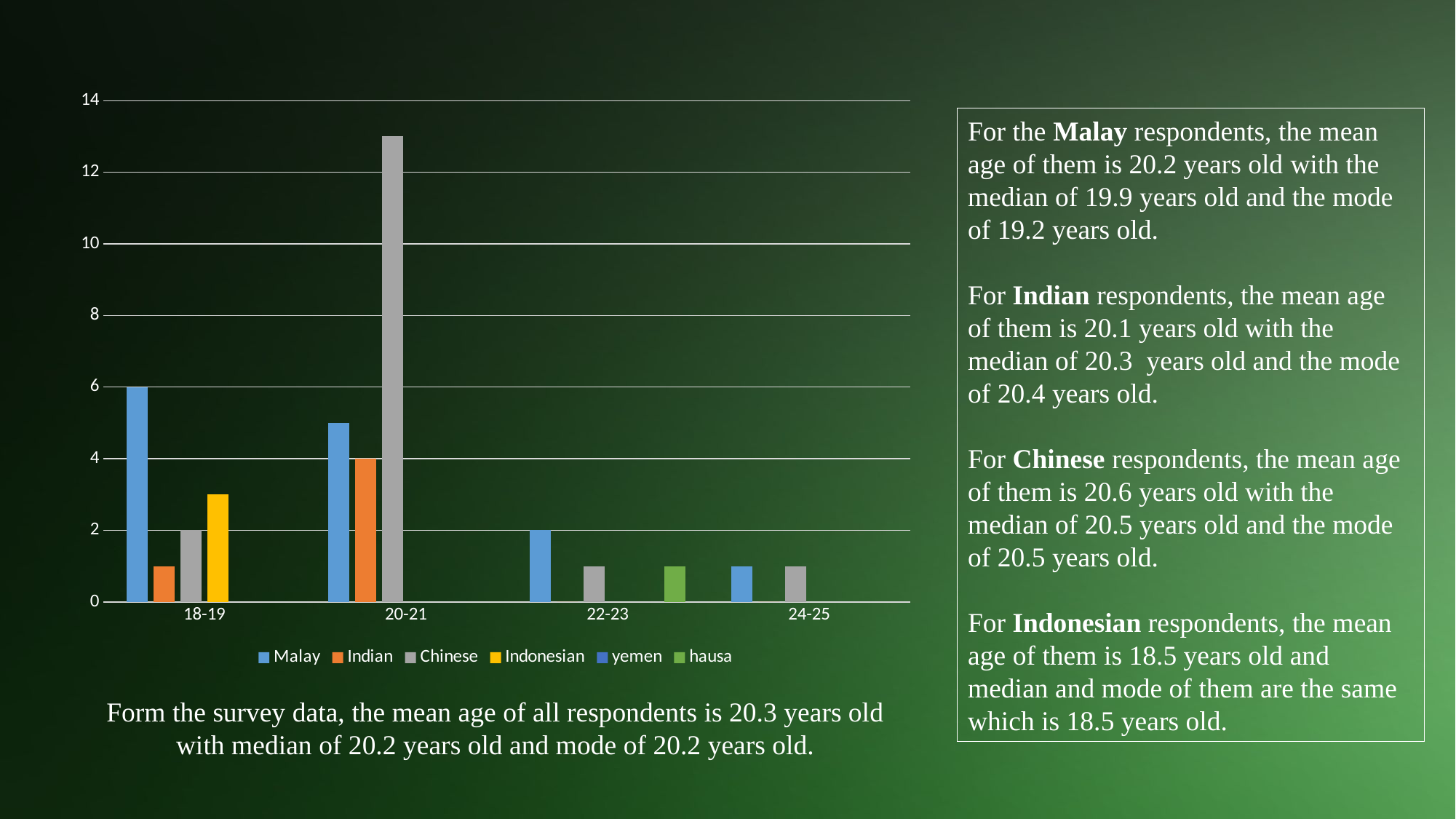
What is the value for Malay in the 22-23 age group? 2 What is the value for Indian in the 20-21 age group? 4 What kind of chart is shown on the slide? bar chart Is the value for Chinese in the 20-21 age group greater or less than 12? greater Which series has the tallest bar in the whole chart? Chinese What is the value for Malay in the 18-19 age group? 6 What is the value for Chinese in the 18-19 age group? 2 How many age-group categories are shown on the x axis? 4 Which series is shown in yellow in the legend? Indonesian Which is larger in the 18-19 age group, Malay or Indian? Malay Is the value for Indonesian in the 18-19 age group greater or less than 4? less How many series does the chart legend list? 6